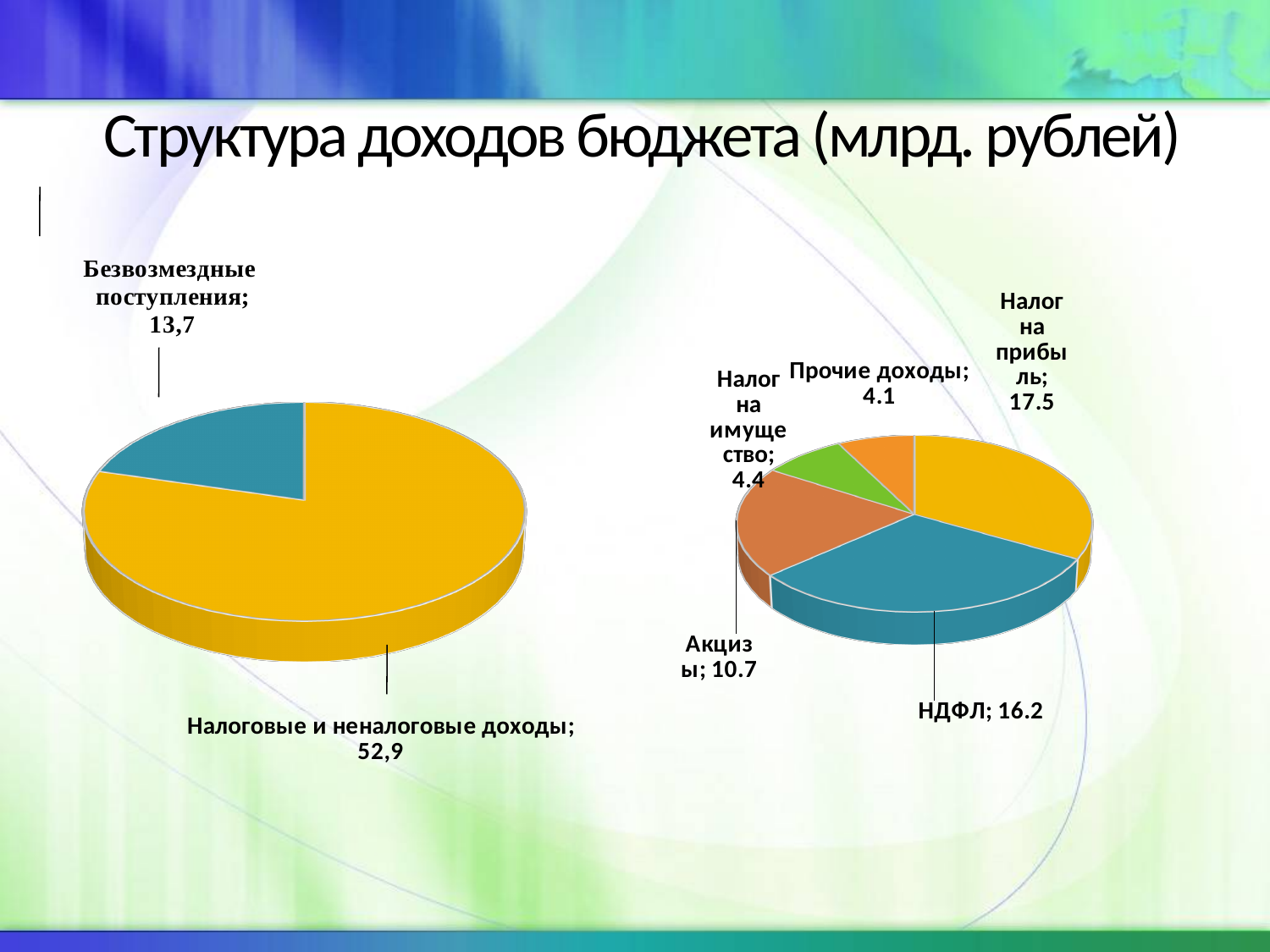
What kind of chart is the left chart on the slide? Pie chart In the right pie chart, what is the difference between Налог на прибыль and НДФЛ? 1.3 In the right pie chart, which category has the largest value? Налог на прибыль In the left pie chart, what is the value for Налоговые и неналоговые доходы? 52,9 How many categories does the right pie chart show? 5 How many categories does the left pie chart show? 2 In the right pie chart, which category has the smallest value? Прочие доходы In the right pie chart, what is the value for Акцизы? 10.7 In the left pie chart, what is the value for Безвозмездные поступления? 13,7 In the right pie chart, what is the value for НДФЛ? 16.2 In the right pie chart, which is larger: Налог на имущество or Прочие доходы? Налог на имущество In the right pie chart, what is the difference between Акцизы and Налог на имущество? 6.3